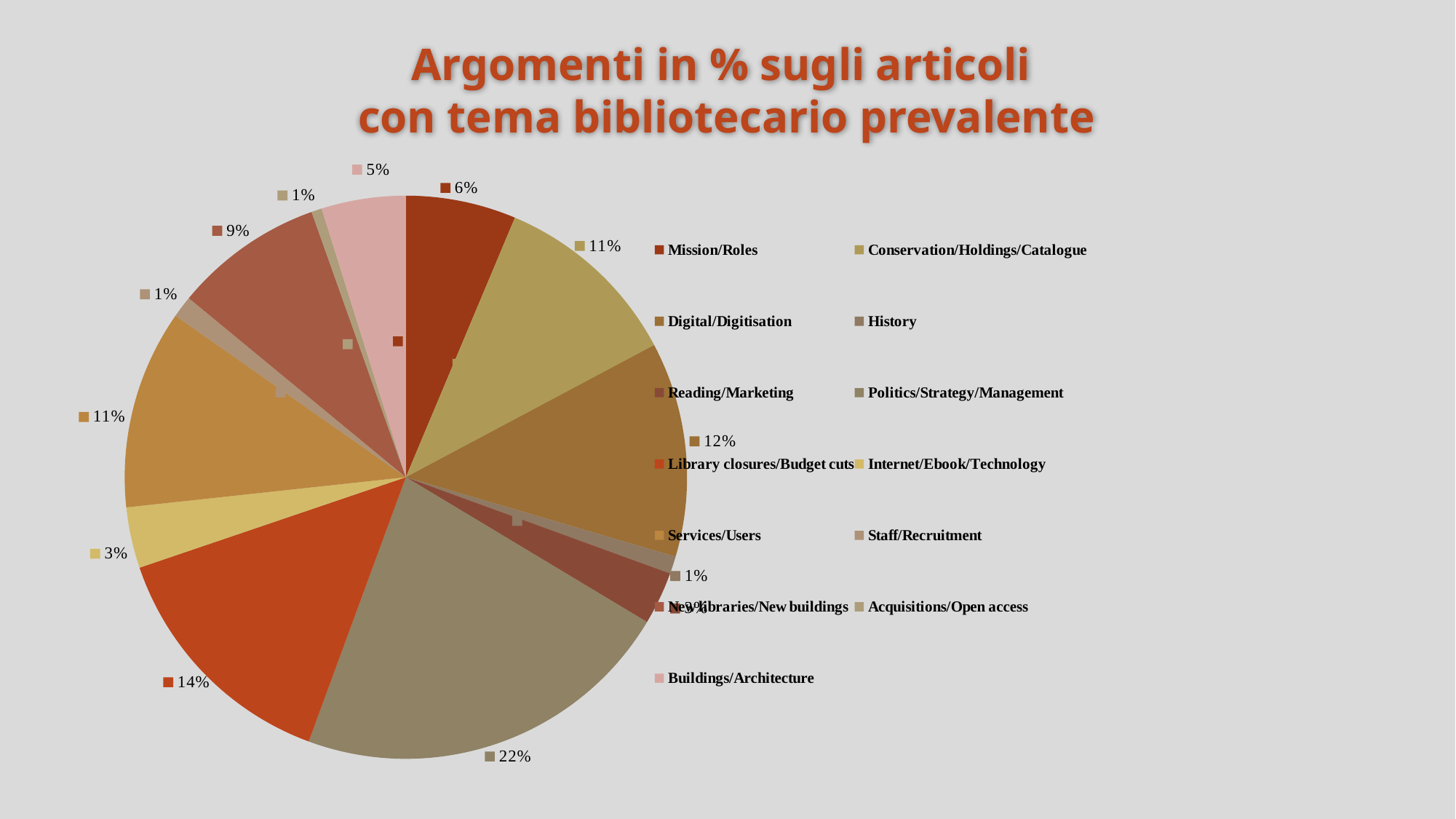
How many categories does the legend list? 13 What percentage is shown for Digital/Digitisation? 12% What percentage is shown for Library closures/Budget cuts? 14% Which has a larger share, Library closures/Budget cuts or Digital/Digitisation? Library closures/Budget cuts What type of chart is shown on the slide? pie chart What percentage is shown for Mission/Roles? 6% What is the title of the chart? Argomenti in % sugli articoli con tema bibliotecario prevalente What percentage is shown for Politics/Strategy/Management? 22% What percentage is shown for New libraries/New buildings? 9% What is the difference in percentage points between Politics/Strategy/Management and Library closures/Budget cuts? 8 Which category has the largest share of the pie? Politics/Strategy/Management What percentage is shown for Buildings/Architecture? 5%